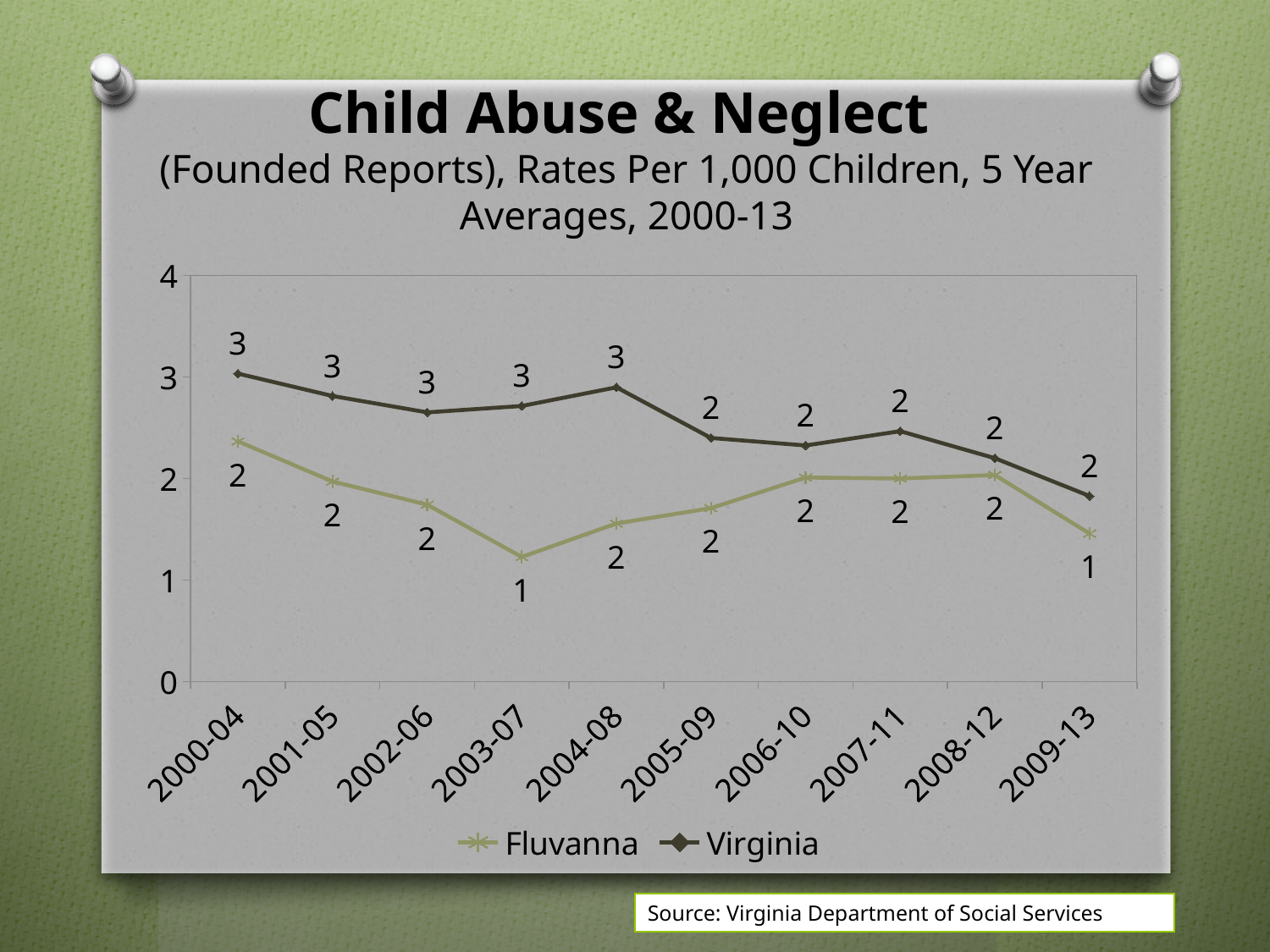
What is the data label for Fluvanna in 2003-07? 1 In which period is the Fluvanna line at its lowest? 2003-07 What is the data label for Virginia in 2009-13? 2 Is the value for Fluvanna in 2000-04 greater or less than 2? greater What kind of chart is shown on the slide? line chart How many series does the legend list? 2 Is the value for Virginia in 2009-13 greater or less than 2? less What is the data label for Virginia in 2000-04? 3 How many time periods are plotted along the x axis? 10 Does the Virginia line generally rise or fall from 2000-04 to 2009-13? fall Which series has the higher value in 2000-04, Fluvanna or Virginia? Virginia In which period is the Virginia line at its highest? 2000-04